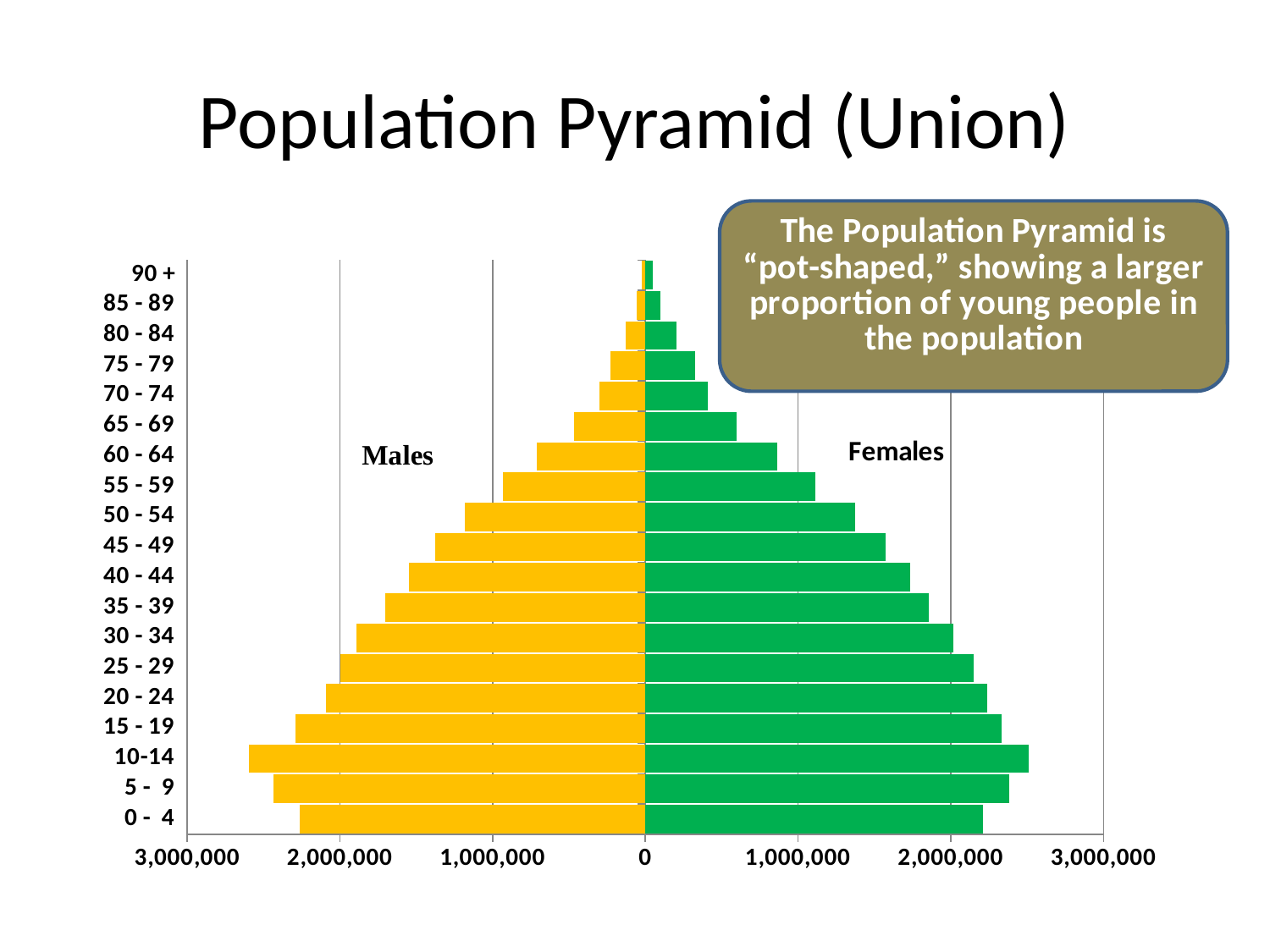
How many age groups are shown on the vertical axis of the population pyramid? 19 Which age group has the shortest bars for both Males and Females? 90 + Is the Males value for the 60 - 64 age group greater or less than 1,000,000? less Which age group has the longest Males bar? 10-14 What colour are the Males bars in the population pyramid? yellow Which age group has the longest Females bar? 10-14 Which is larger, the Males value for 30 - 34 or the Males value for 50 - 54? 30 - 34 Is the Males value for the 10-14 age group greater or less than 2,000,000? greater What kind of chart is shown on the slide? bar chart Is the Females value for the 55 - 59 age group greater or less than 1,000,000? greater How many series (sexes) does the population pyramid show? 2